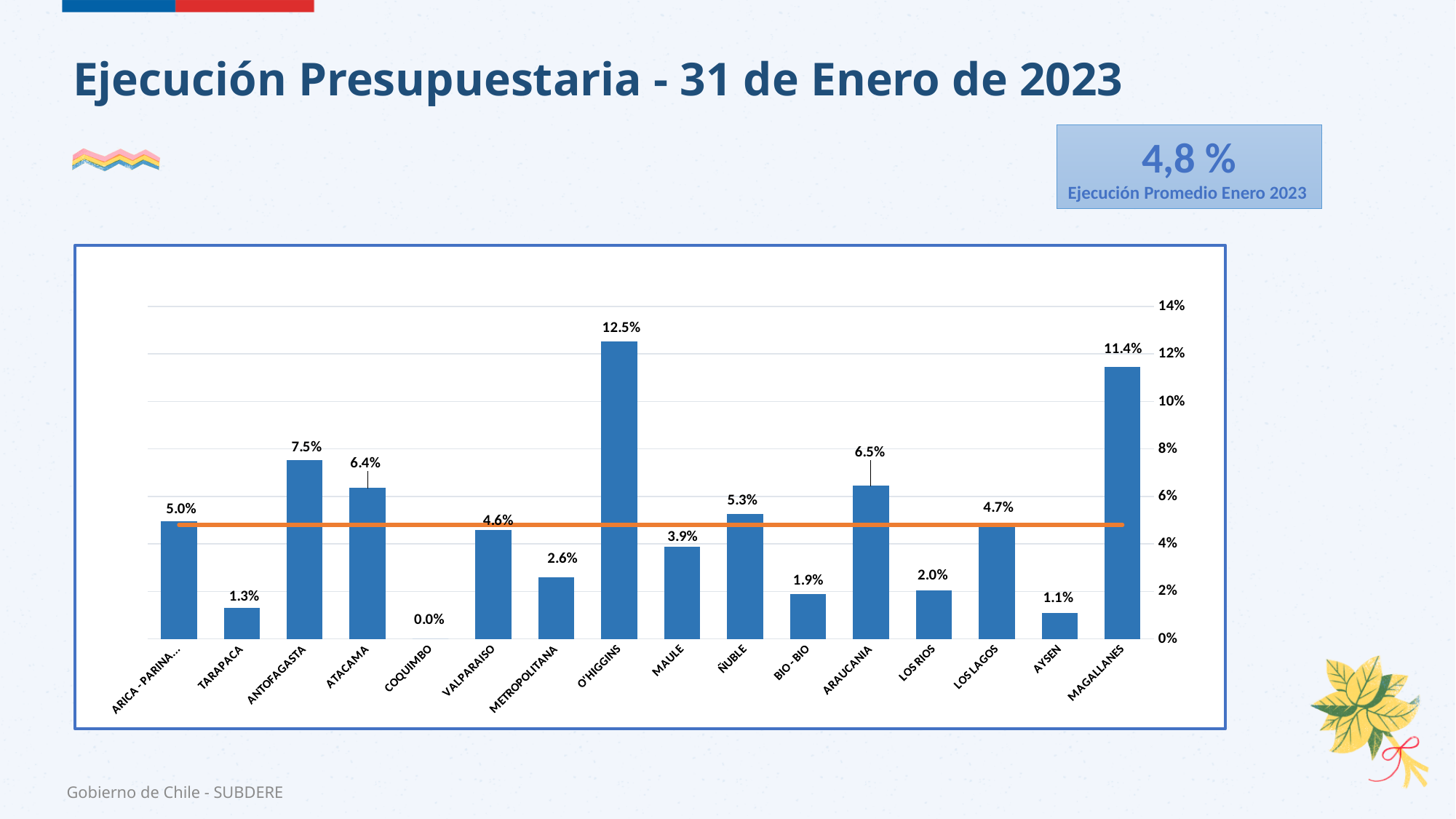
What is the difference between the values for O'HIGGINS and MAGALLANES? 1.1% Is the value for MAGALLANES greater or less than 10%? greater What is the difference between the values for ARAUCANIA and ATACAMA? 0.1% How many regions are shown on the x axis? 16 Which region has the lowest value? COQUIMBO Which region has the highest value? O'HIGGINS What value does the box in the top right give as the average execution for January 2023? 4,8 % What is the value for ANTOFAGASTA? 7.5% What kind of chart is shown on the slide? bar chart What is the value for O'HIGGINS? 12.5% Which is larger, the value for MAULE or the value for METROPOLITANA? MAULE What is the value for LOS LAGOS? 4.7%